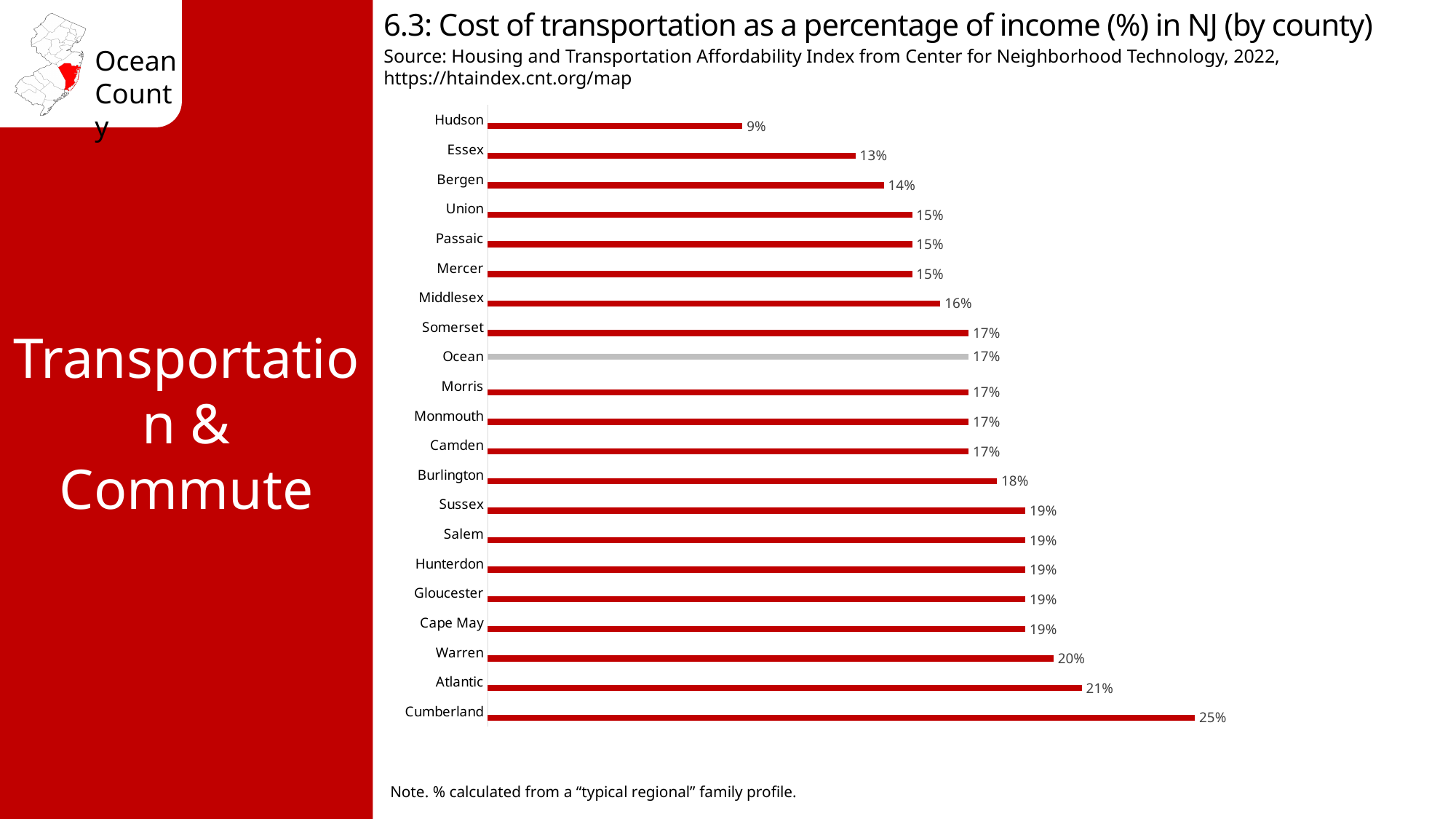
What is the difference in percentage points between Cumberland and Hudson? 16 What type of chart is shown on the slide? Bar chart What is the value shown for Hudson? 9% Which county has the highest cost of transportation as a percentage of income? Cumberland Which has a higher value, Bergen or Burlington? Burlington What is the difference in percentage points between Atlantic and Ocean? 4 What is the cost of transportation as a percentage of income for Ocean County? 17% Which county's bar is shown in grey rather than red? Ocean Which county has the lowest cost of transportation as a percentage of income? Hudson How many counties are shown in the chart? 21 What is the value shown for Atlantic? 21% What is the value shown for Cumberland? 25%